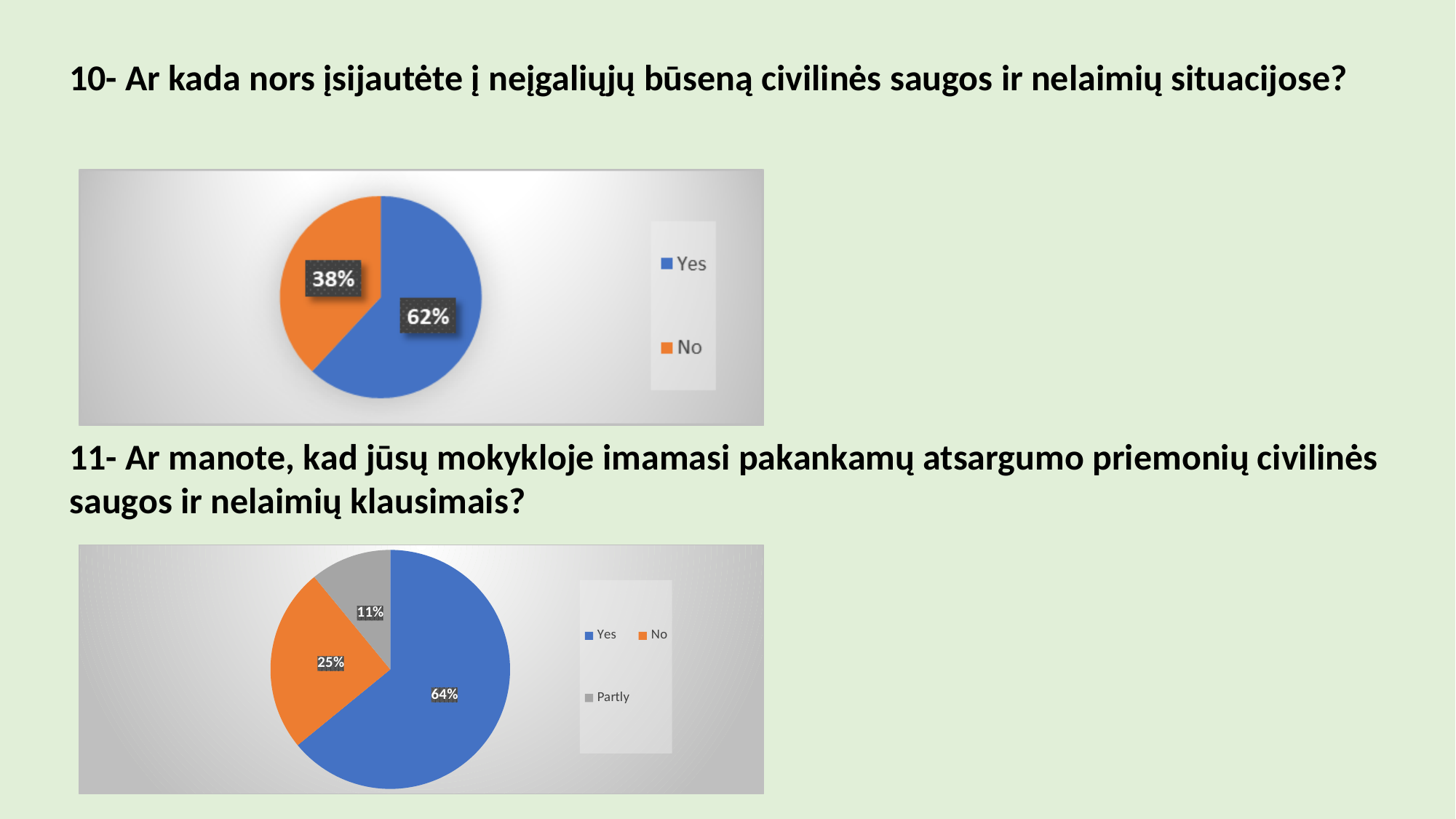
In the top pie chart (question 10), what percentage of respondents answered Yes? 62% In the bottom pie chart (question 11), what colour is the Partly slice? Grey In the bottom pie chart (question 11), what percentage of respondents answered Partly? 11% In the top pie chart (question 10), which answer has the largest share? Yes In the top pie chart (question 10), what is the difference in percentage points between Yes and No? 24 In the bottom pie chart (question 11), what percentage of respondents answered No? 25% In the bottom pie chart (question 11), which answer has the smallest share? Partly What type of chart is shown for question 10? Pie chart In the top pie chart (question 10), what percentage of respondents answered No? 38% In the top pie chart (question 10), how many entries does the legend list? 2 In the bottom pie chart (question 11), which is larger, the share for No or the share for Partly? No In the bottom pie chart (question 11), how many slices does the pie have? 3